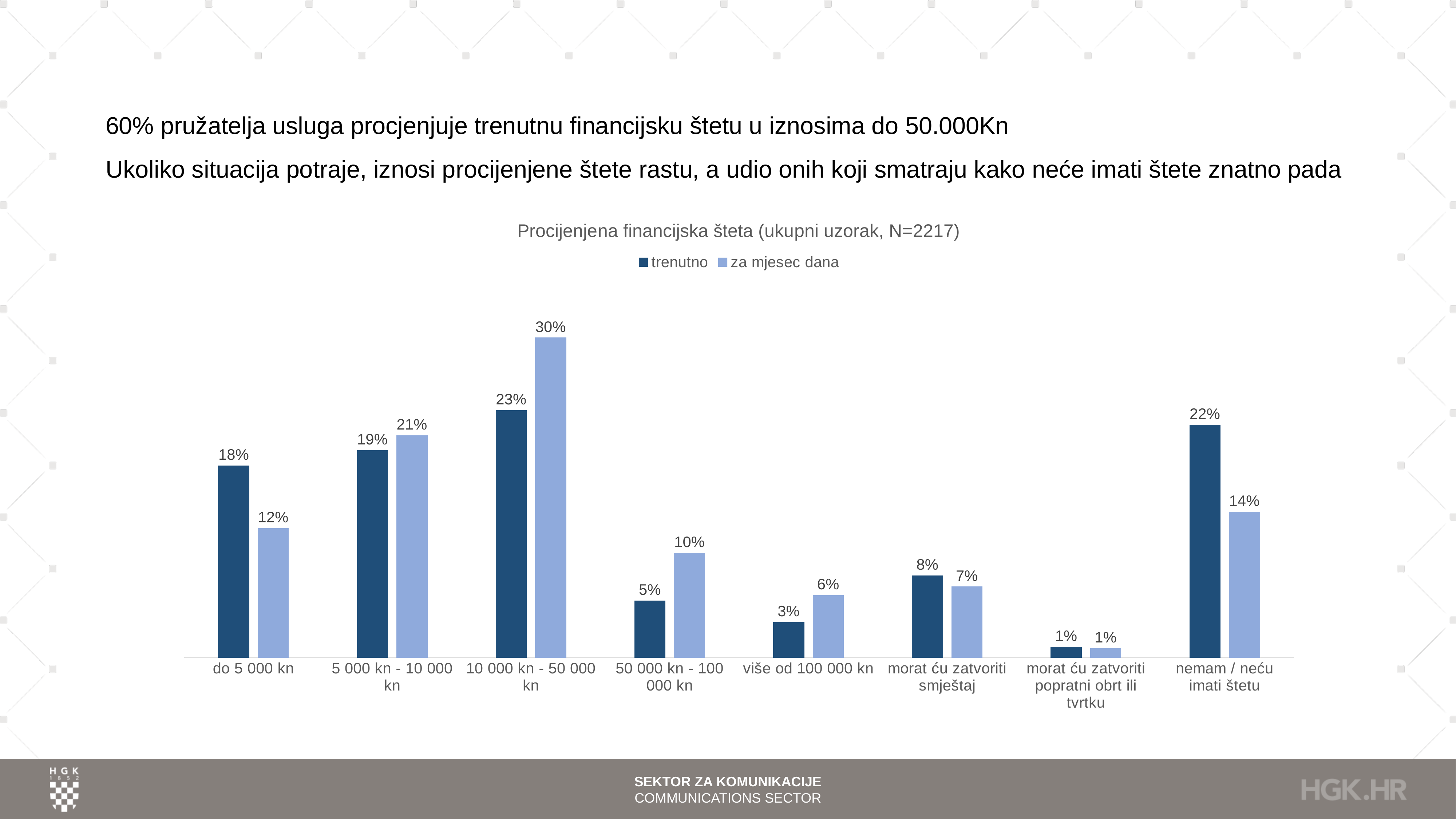
What kind of chart is shown on the slide? bar chart How many series does the legend list? 2 What is the value for "za mjesec dana" in the "10 000 kn - 50 000 kn" category? 30% Which category has the lowest "za mjesec dana" value? morat ću zatvoriti popratni obrt ili tvrtku What is the value for "za mjesec dana" in the "nemam / neću imati štetu" category? 14% What is the title of the chart? Procijenjena financijska šteta (ukupni uzorak, N=2217) What is the value for "trenutno" in the "do 5 000 kn" category? 18% What is the difference between the "trenutno" and "za mjesec dana" values for "nemam / neću imati štetu"? 8% Which category has the highest "trenutno" value? 10 000 kn - 50 000 kn Which is larger for "50 000 kn - 100 000 kn": the "trenutno" value or the "za mjesec dana" value? za mjesec dana How many categories are shown on the x axis? 8 What is the difference between the "za mjesec dana" and "trenutno" values for "10 000 kn - 50 000 kn"? 7%